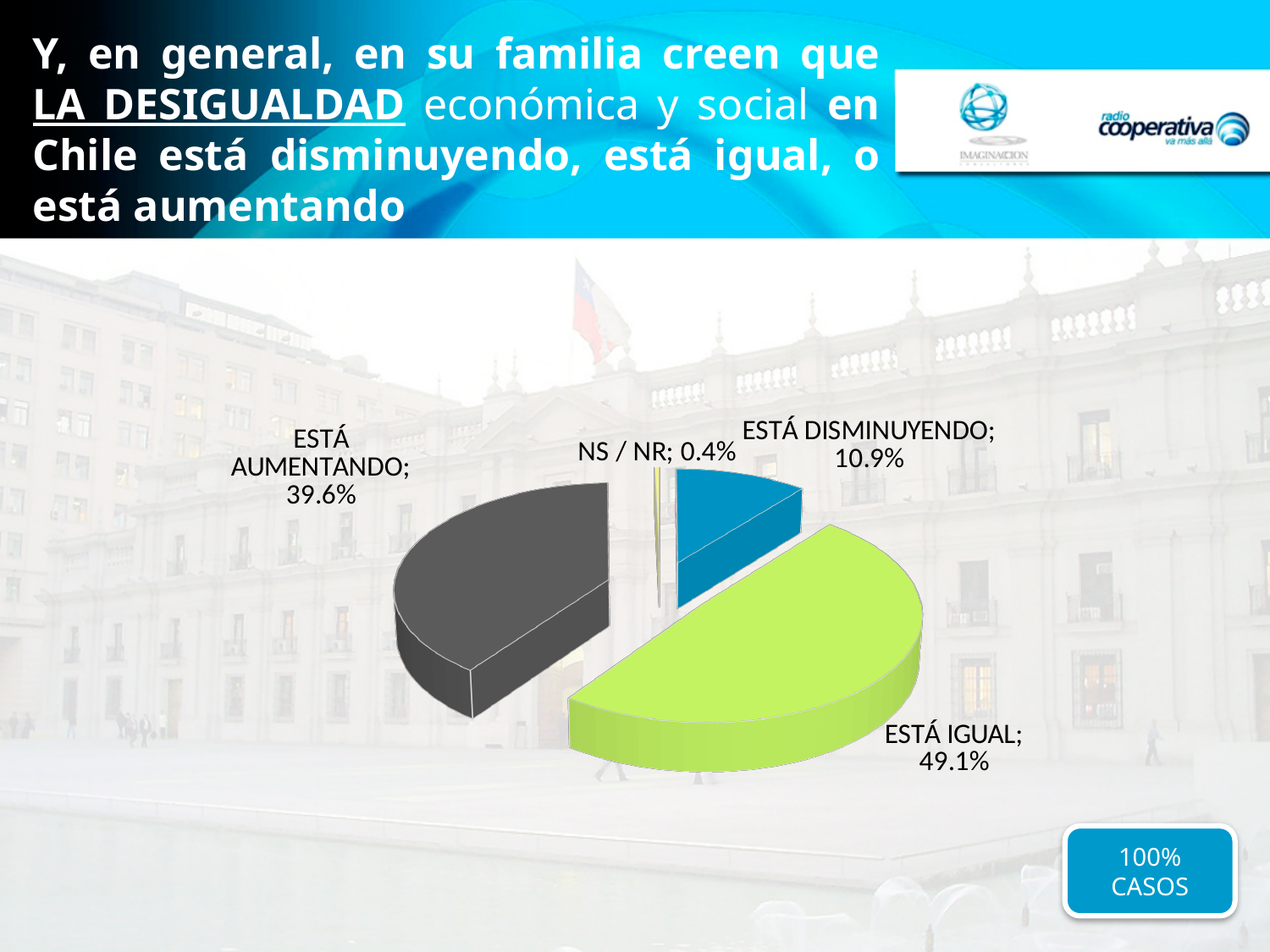
Which category has the smallest share of the pie? NS / NR What kind of chart is shown on the slide? Pie chart Which is larger, the share for 'ESTÁ AUMENTANDO' or for 'ESTÁ DISMINUYENDO'? ESTÁ AUMENTANDO What is the difference between the 'ESTÁ DISMINUYENDO' and 'NS / NR' shares? 10.5% What percentage of respondents said inequality 'ESTÁ IGUAL'? 49.1% What colour is the 'ESTÁ IGUAL' slice of the pie? Green What percentage is shown for 'NS / NR'? 0.4% What percentage of respondents said inequality 'ESTÁ DISMINUYENDO'? 10.9% How many categories are shown in the pie chart? 4 What percentage of respondents said inequality 'ESTÁ AUMENTANDO'? 39.6% What is the difference between the 'ESTÁ IGUAL' and 'ESTÁ AUMENTANDO' shares? 9.5% Which category has the largest share of the pie? ESTÁ IGUAL